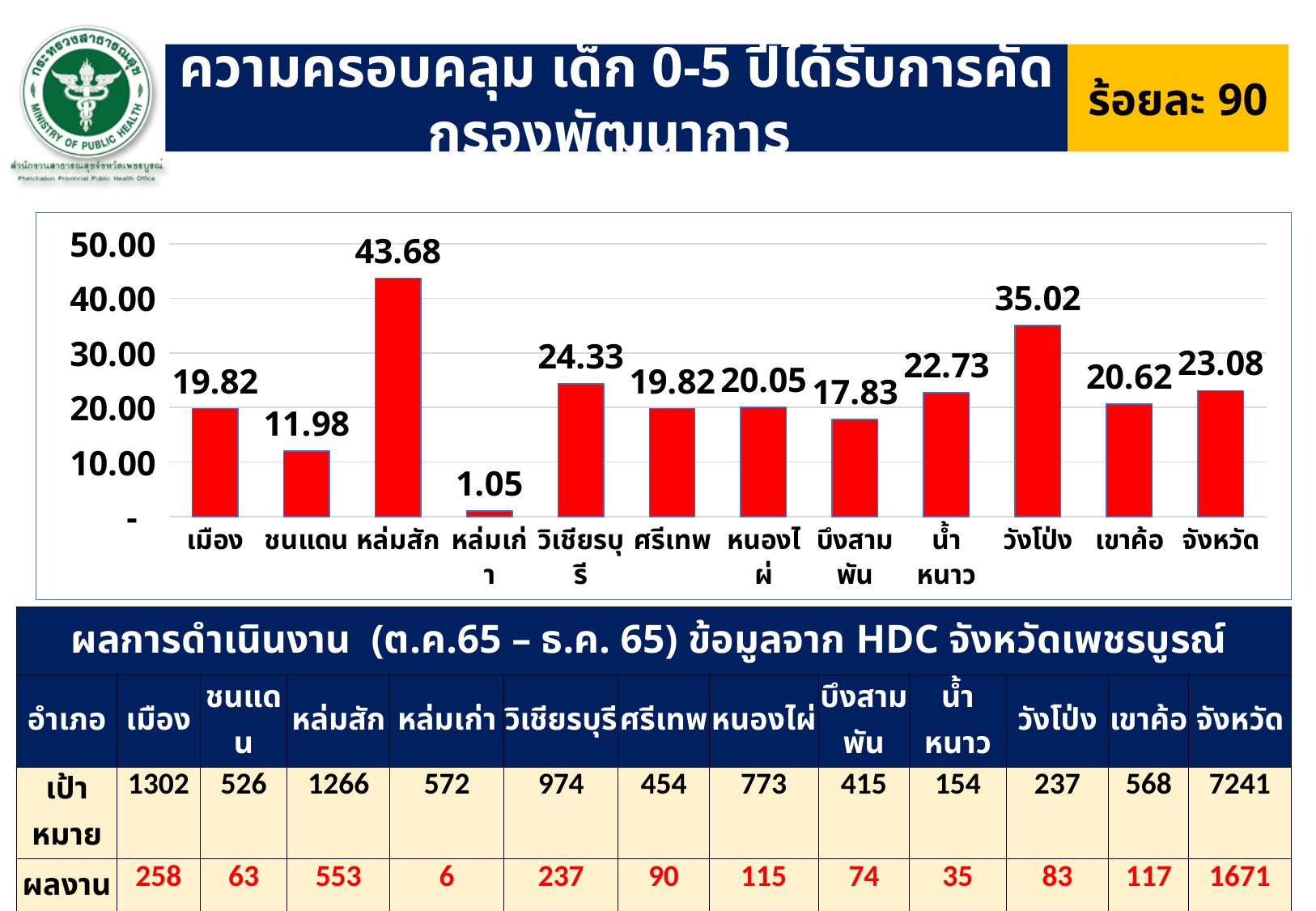
What is the value shown for หล่มสัก in the bar chart? 43.68 What is the value shown for วังโป่ง in the bar chart? 35.02 What is the difference between the values for หล่มสัก and วังโป่ง in the bar chart? 8.66 How many categories are shown on the x axis of the bar chart? 12 What is the value shown for บึงสามพัน in the bar chart? 17.83 Is the value for ชนแดน in the bar chart greater or less than 20.00? less Which category has the lowest value in the bar chart? หล่มเก่า What colour are the bars in the chart? red Which has a larger value in the bar chart, วิเชียรบุรี or น้ำหนาว? วิเชียรบุรี What kind of chart is shown on the slide? bar chart Which category has the highest value in the bar chart? หล่มสัก What is the value shown for จังหวัด in the bar chart? 23.08